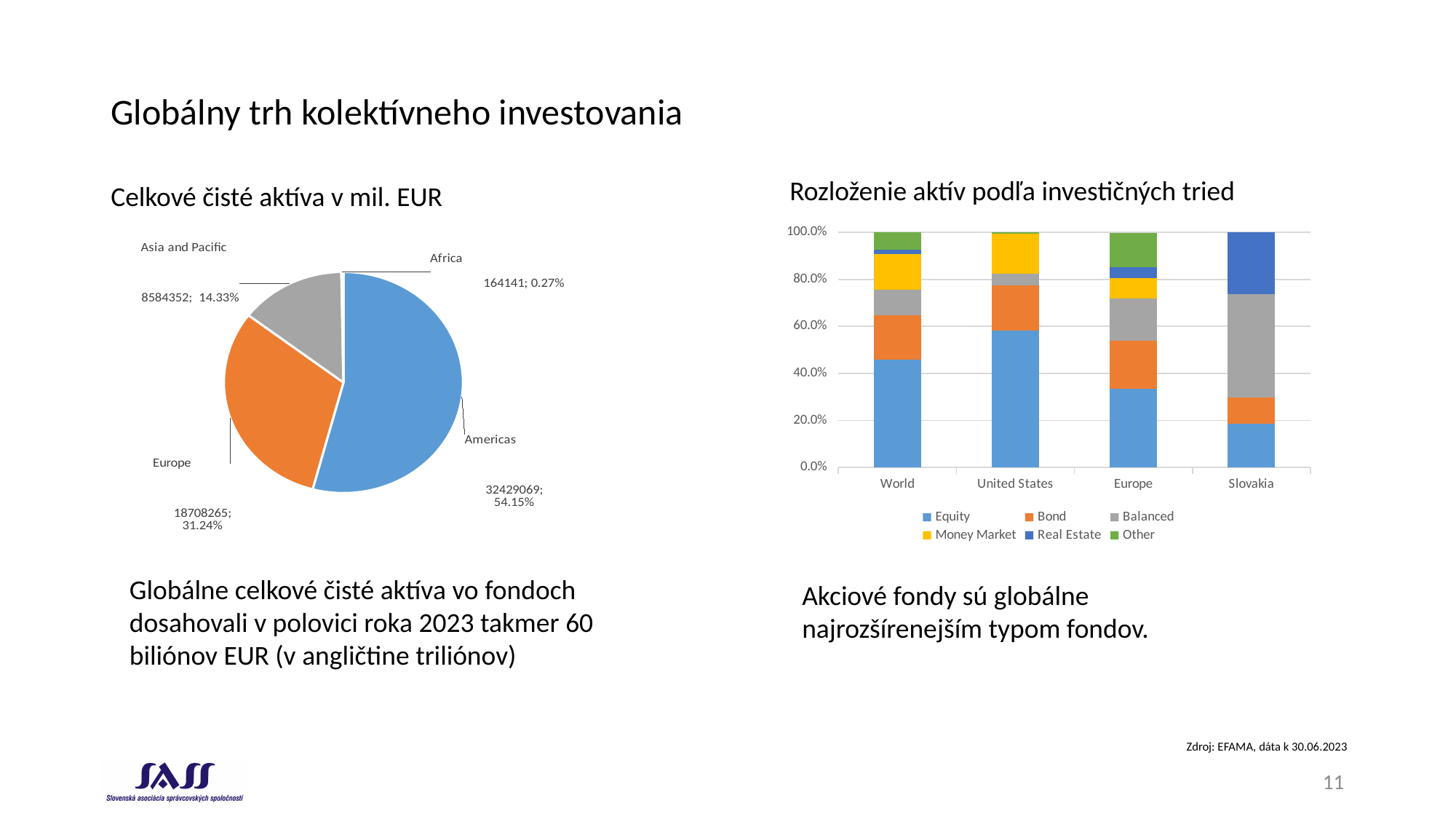
What kind of chart is 'Rozloženie aktív podľa investičných tried'? Stacked bar chart In the chart 'Rozloženie aktív podľa investičných tried', which has the larger Equity share, United States or Slovakia? United States In the pie chart 'Celkové čisté aktíva v mil. EUR', what is the value for Europe? 18708265 In the pie chart 'Celkové čisté aktíva v mil. EUR', what share of the pie does Asia and Pacific hold? 14.33% How many slices does the pie chart 'Celkové čisté aktíva v mil. EUR' have? 4 How many series does the legend of the chart 'Rozloženie aktív podľa investičných tried' list? 6 In the pie chart 'Celkové čisté aktíva v mil. EUR', which region has the largest slice? Americas In the chart 'Rozloženie aktív podľa investičných tried', is the Equity share for United States greater or less than 40.0%? greater In the pie chart 'Celkové čisté aktíva v mil. EUR', which region has the smallest slice? Africa In the pie chart 'Celkové čisté aktíva v mil. EUR', what is the value for Americas? 32429069 In the pie chart 'Celkové čisté aktíva v mil. EUR', what share of the pie does Africa hold? 0.27% In the pie chart 'Celkové čisté aktíva v mil. EUR', what is the difference between the values for Americas and Europe? 13720804